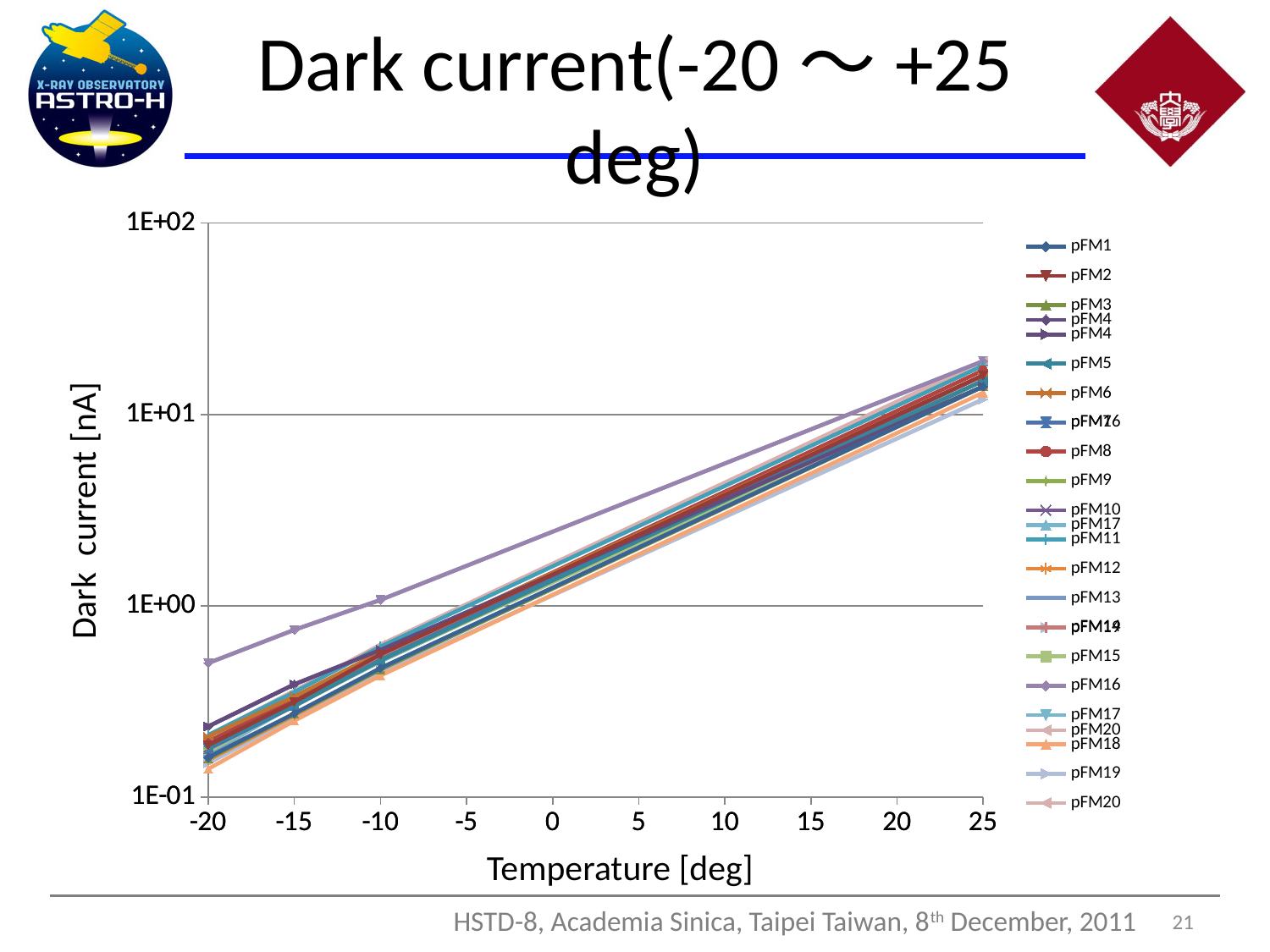
Is the dark current for pFM1 at 25 deg greater or less than 1E+01 nA? greater Is the dark current for pFM2 at -20 deg greater or less than 1E+00 nA? less Is the dark current for pFM12 at 25 deg greater or less than 1E+02 nA? less What is the label of the y axis? Dark current [nA] What is the label of the x axis? Temperature [deg] Do the dark current values rise or fall as temperature increases from -20 to 25 deg? rise What kind of chart is shown on the slide? line chart